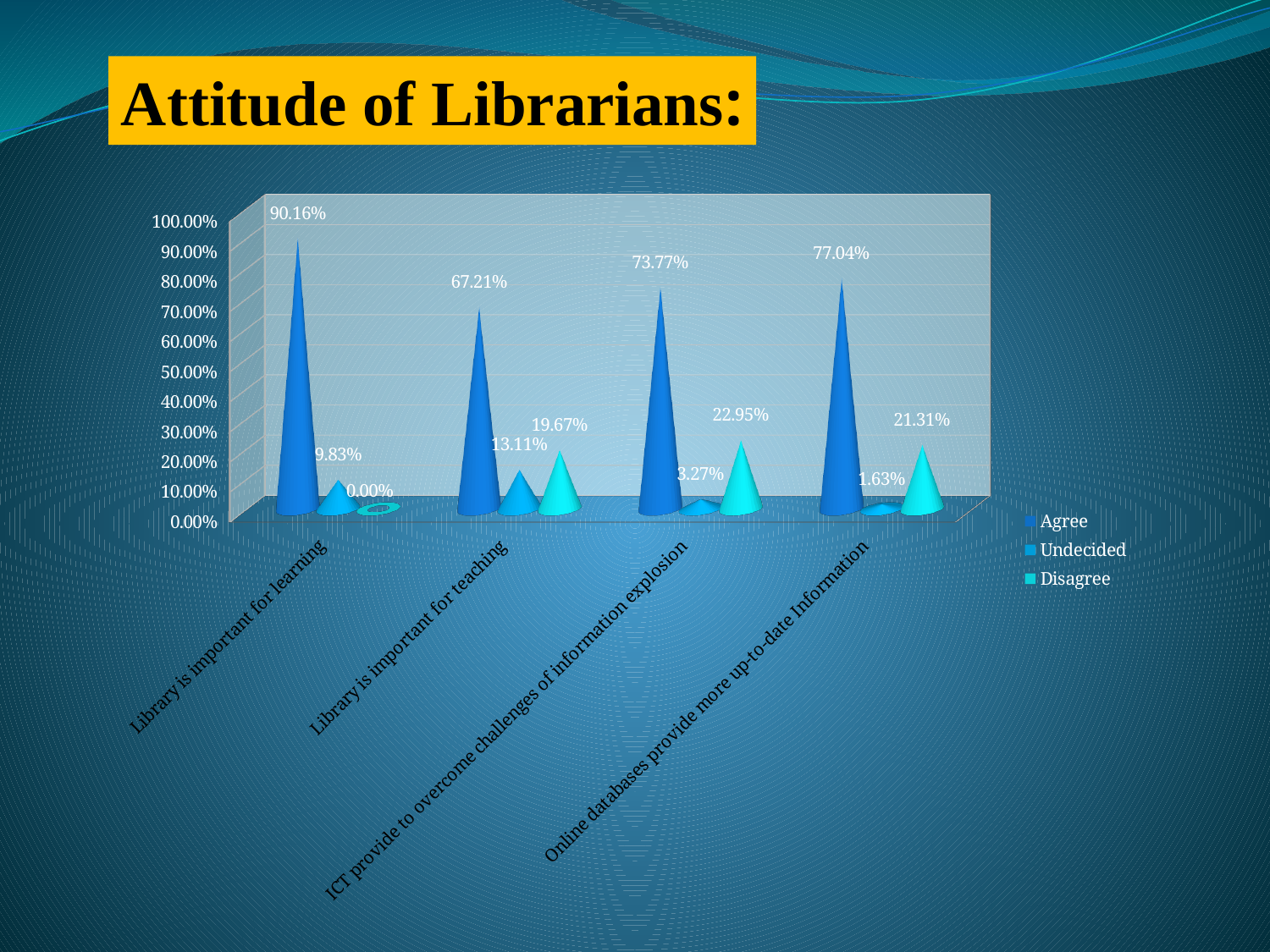
How many series does the legend list? 3 What is the Disagree value for "Library is important for teaching"? 19.67% What kind of chart is shown on the slide? Bar chart How many categories are shown on the x axis? 4 Which is larger: the Undecided value for "Library is important for learning" or the Undecided value for "ICT provide to overcome challenges of information explosion"? Library is important for learning What is the Disagree value for "ICT provide to overcome challenges of information explosion"? 22.95% Which category has the highest Agree value? Library is important for learning What is the Agree value for "Library is important for learning"? 90.16% What is the difference between the Agree values for "Library is important for learning" and "Library is important for teaching"? 22.95% Which category has the lowest Agree value? Library is important for teaching What is the title of the slide? Attitude of Librarians: What is the Undecided value for "Online databases provide more up-to-date Information"? 1.63%